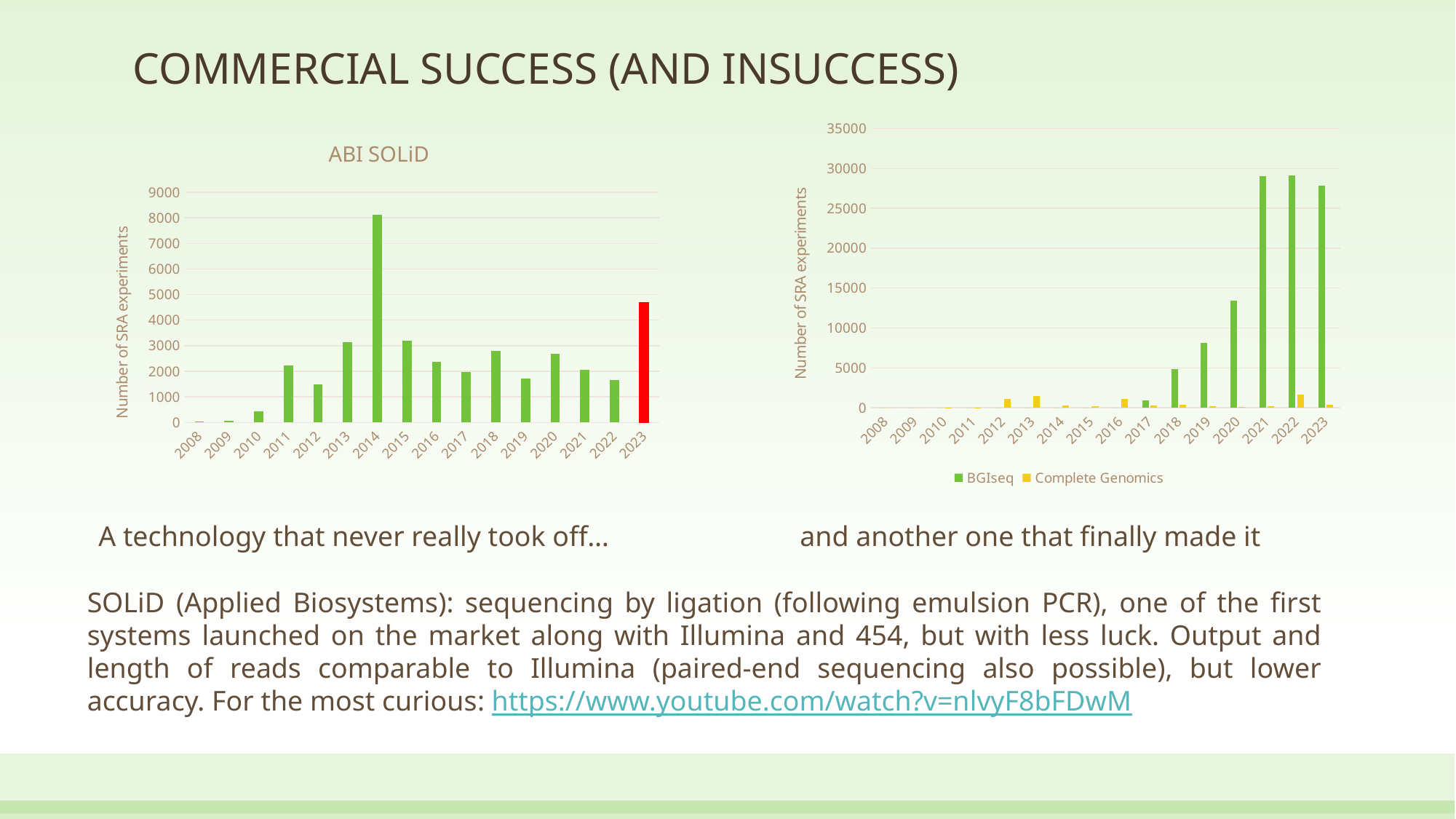
On the right-hand chart, which series has the larger value in 2020, BGIseq or Complete Genomics? BGIseq How many series does the legend of the right-hand chart list? 2 On the right-hand chart, is the BGIseq value for 2020 greater or less than 10000? greater On the ABI SOLiD chart, which year has the lowest number of SRA experiments? 2008 On the ABI SOLiD chart, is the value for 2012 greater or less than 2000? less How many years are shown on the x axis of the ABI SOLiD chart? 16 On the ABI SOLiD chart, which year has the highest number of SRA experiments? 2014 On the ABI SOLiD chart, is the value for 2023 greater or less than 4000? greater What kind of chart is the ABI SOLiD chart? bar chart On the right-hand chart, do the BGIseq values rise or fall from 2017 to 2021? rise On the ABI SOLiD chart, which year has the larger value, 2014 or 2023? 2014